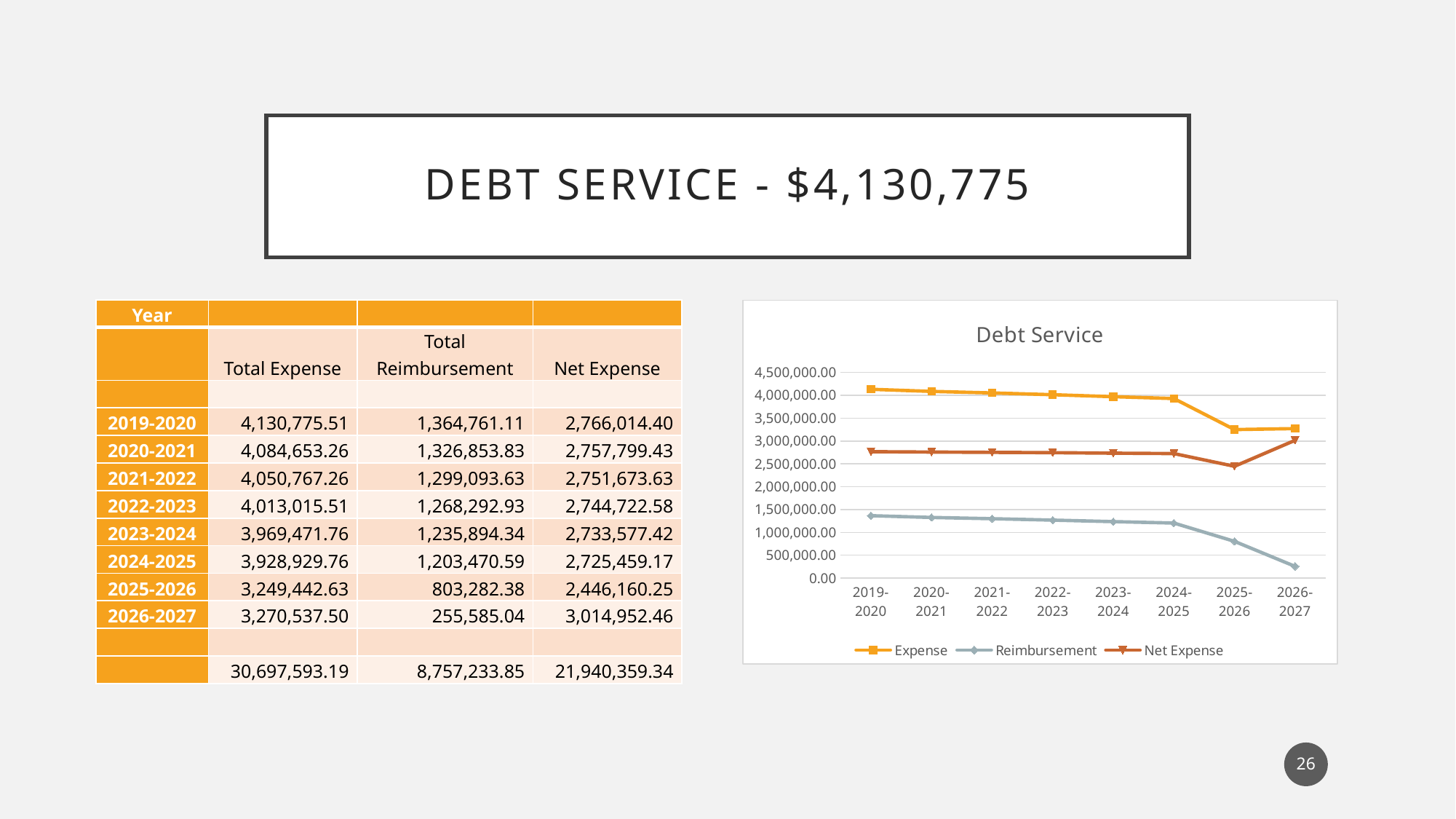
In the Debt Service chart, is the Expense value for 2019-2020 greater or less than 4,000,000.00? greater In the Debt Service chart, which is larger for 2019-2020: Expense or Net Expense? Expense How many series does the legend of the Debt Service chart list? 3 How many fiscal years are plotted along the x axis of the Debt Service chart? 8 What kind of chart is the Debt Service chart? line chart In the Debt Service chart, which year has the lowest Reimbursement value? 2026-2027 In the Debt Service chart, is the Reimbursement value for 2026-2027 greater or less than 500,000.00? less What is the title of the chart on the slide? Debt Service What is the Total Expense value for 2019-2020 shown on the slide? 4,130,775.51 In the Debt Service chart, is the Net Expense value for 2025-2026 greater or less than 3,000,000.00? less In the Debt Service chart, which year has the lowest Net Expense value? 2025-2026 In the Debt Service chart, does the Expense line rise or fall from 2019-2020 to 2026-2027? fall